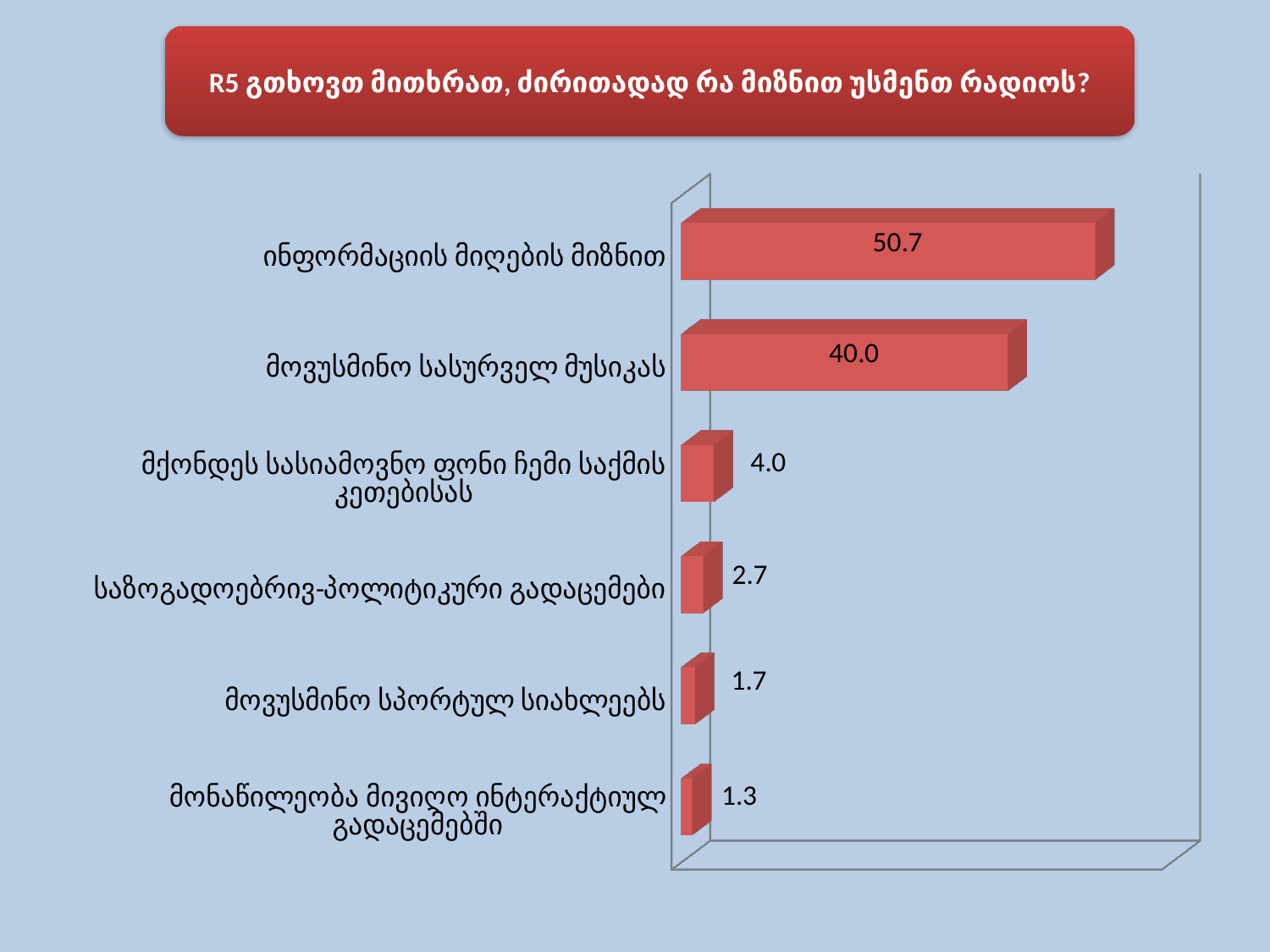
Which category has the lowest value? მონაწილეობა მივიღო ინტერაქტიულ გადაცემებში What is the value for "მოვუსმინო სპორტულ სიახლეებს"? 1.7 What is the value for "საზოგადოებრივ-პოლიტიკური გადაცემები"? 2.7 What is the value for "მონაწილეობა მივიღო ინტერაქტიულ გადაცემებში"? 1.3 What is the value for "მქონდეს სასიამოვნო ფონი ჩემი საქმის კეთებისას"? 4.0 How many categories are shown in the chart? 6 What kind of chart is shown on the slide? Bar chart Which is larger, the value for "საზოგადოებრივ-პოლიტიკური გადაცემები" or for "მოვუსმინო სპორტულ სიახლეებს"? საზოგადოებრივ-პოლიტიკური გადაცემები What is the value for "მოვუსმინო სასურველ მუსიკას"? 40.0 Which category has the highest value? ინფორმაციის მიღების მიზნით What is the difference between the values for "ინფორმაციის მიღების მიზნით" and "მოვუსმინო სასურველ მუსიკას"? 10.7 What is the value for "ინფორმაციის მიღების მიზნით"? 50.7